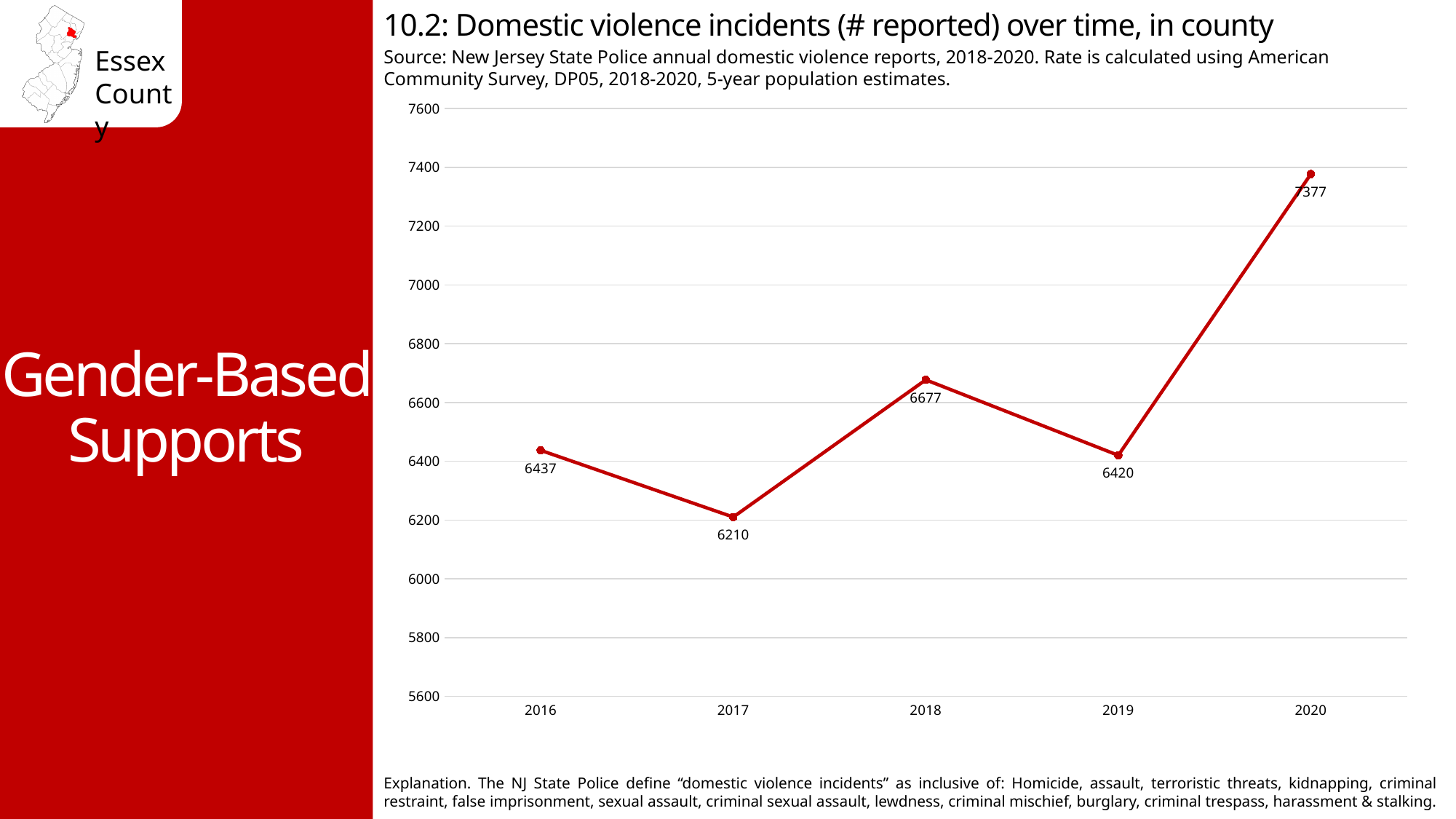
Which year had the highest number of reported domestic violence incidents? 2020 What was the number of reported domestic violence incidents in 2016? 6437 Is the value for 2018 greater or less than 6600? greater What was the number of reported domestic violence incidents in 2020? 7377 Which year had the lowest number of reported domestic violence incidents? 2017 Did the number of reported incidents rise or fall from 2019 to 2020? Rise How many years are plotted on the chart? 5 What kind of chart is shown on the slide? Line chart What is the difference in reported incidents between 2020 and 2019? 957 What was the number of reported domestic violence incidents in 2018? 6677 What is the difference in reported incidents between 2016 and 2017? 227 Which year had more reported incidents, 2016 or 2019? 2016